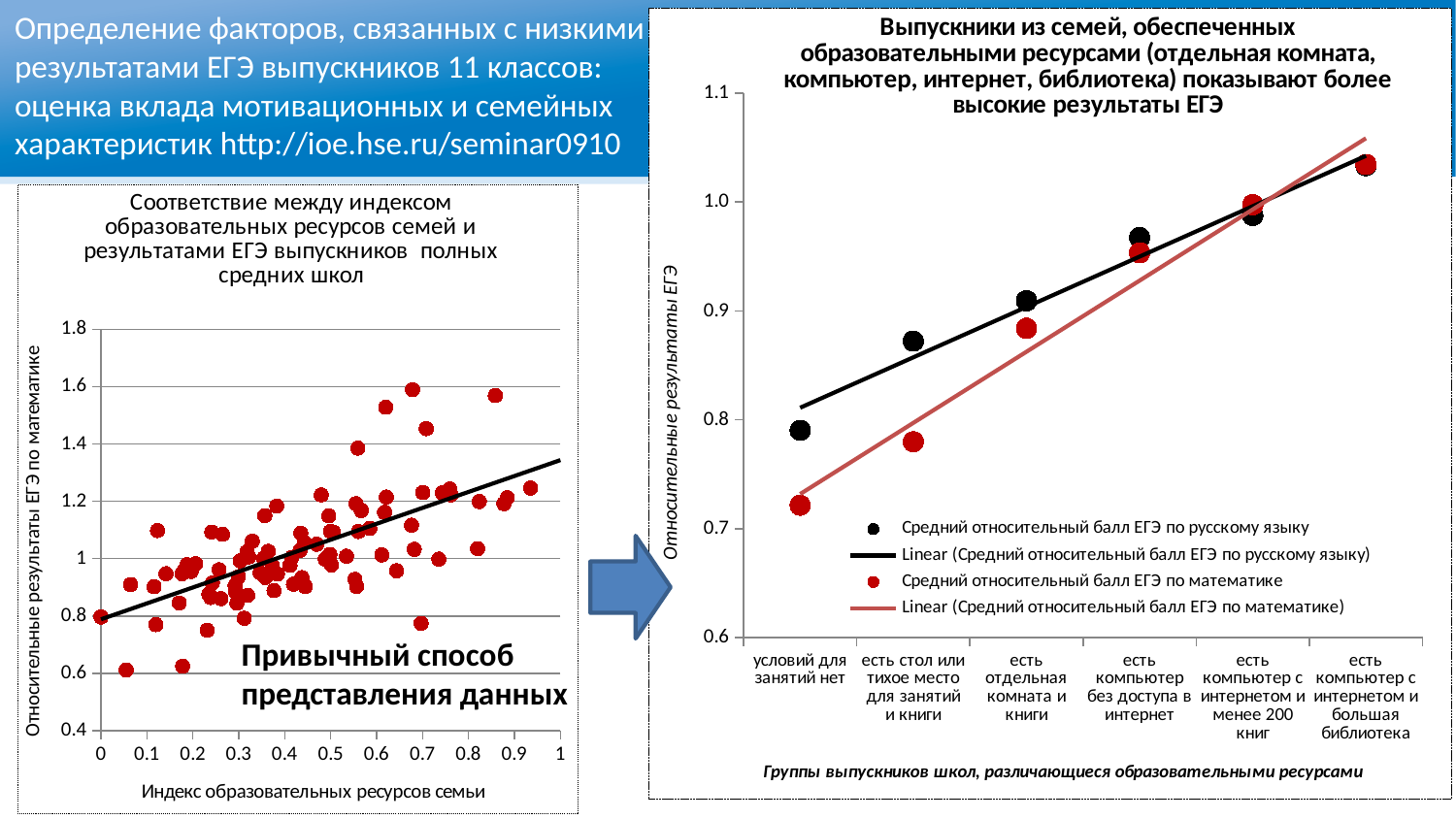
In the right chart, is the average relative Russian exam score for the group 'есть компьютер с интернетом и большая библиотека' greater or less than 1.0? greater What is the highest value shown on the y axis of the left chart? 1.8 In the right chart, how many entries does the legend list? 4 In the right chart, is the average relative math exam score for the group 'условий для занятий нет' greater or less than 0.8? less In the right chart, is the average relative Russian exam score for the group 'есть стол или тихое место для занятий и книги' greater or less than 0.8? greater In the right chart, for the group 'условий для занятий нет', which is higher: the average relative score in Russian or in mathematics? Russian What is the title of the x axis of the left chart? Индекс образовательных ресурсов семьи In the left chart, do the relative math exam results generally rise or fall as the family educational resources index increases? Rise In the right chart, how many groups of school graduates are shown along the x axis? 6 What kind of chart is the left chart titled 'Соответствие между индексом образовательных ресурсов семей и результатами ЕГЭ выпускников полных средних школ'? Scatter plot In the right chart, do the relative exam results rise or fall from the group 'условий для занятий нет' to the group 'есть компьютер с интернетом и большая библиотека'? Rise In the right chart, which group has the lowest average relative math exam score? условий для занятий нет